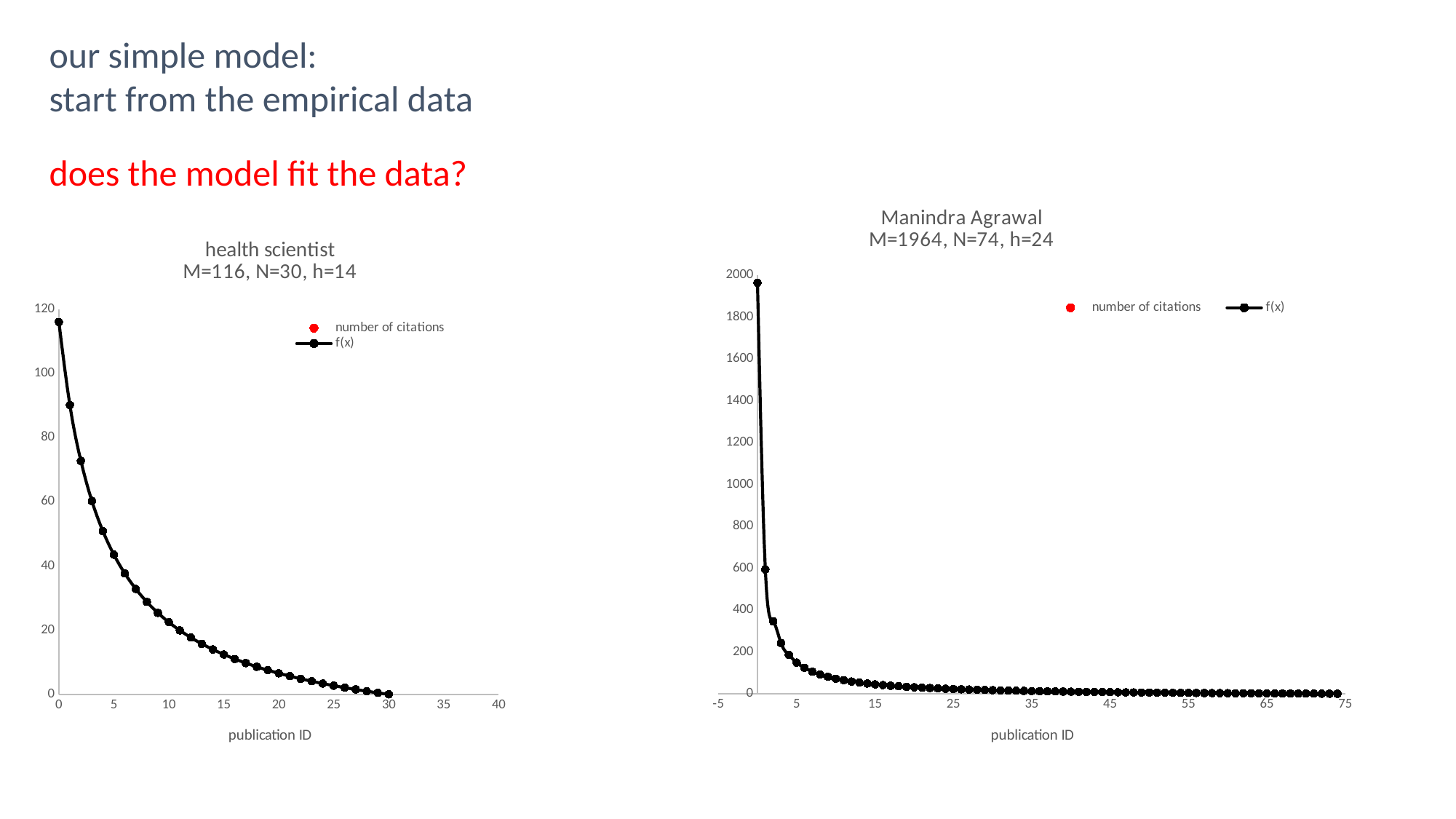
In the 'health scientist' chart, is the value at publication ID 20 greater or less than 20? less In the 'Manindra Agrawal' chart, do the values rise or fall along the x axis? fall In the 'health scientist' chart, do the values rise or fall as publication ID increases? fall In the 'Manindra Agrawal' chart, which publication ID has the highest value? 0 What are the two legend entries in the 'health scientist' chart? number of citations, f(x) In the 'health scientist' chart, is the value at publication ID 1 greater or less than 80? greater In the 'Manindra Agrawal' chart, is the value at publication ID 5 greater or less than 200? less How many series does the legend of the 'Manindra Agrawal' chart list? 2 What is the x-axis label of the 'Manindra Agrawal' chart? publication ID What kind of chart is the 'health scientist' chart on the left? line chart